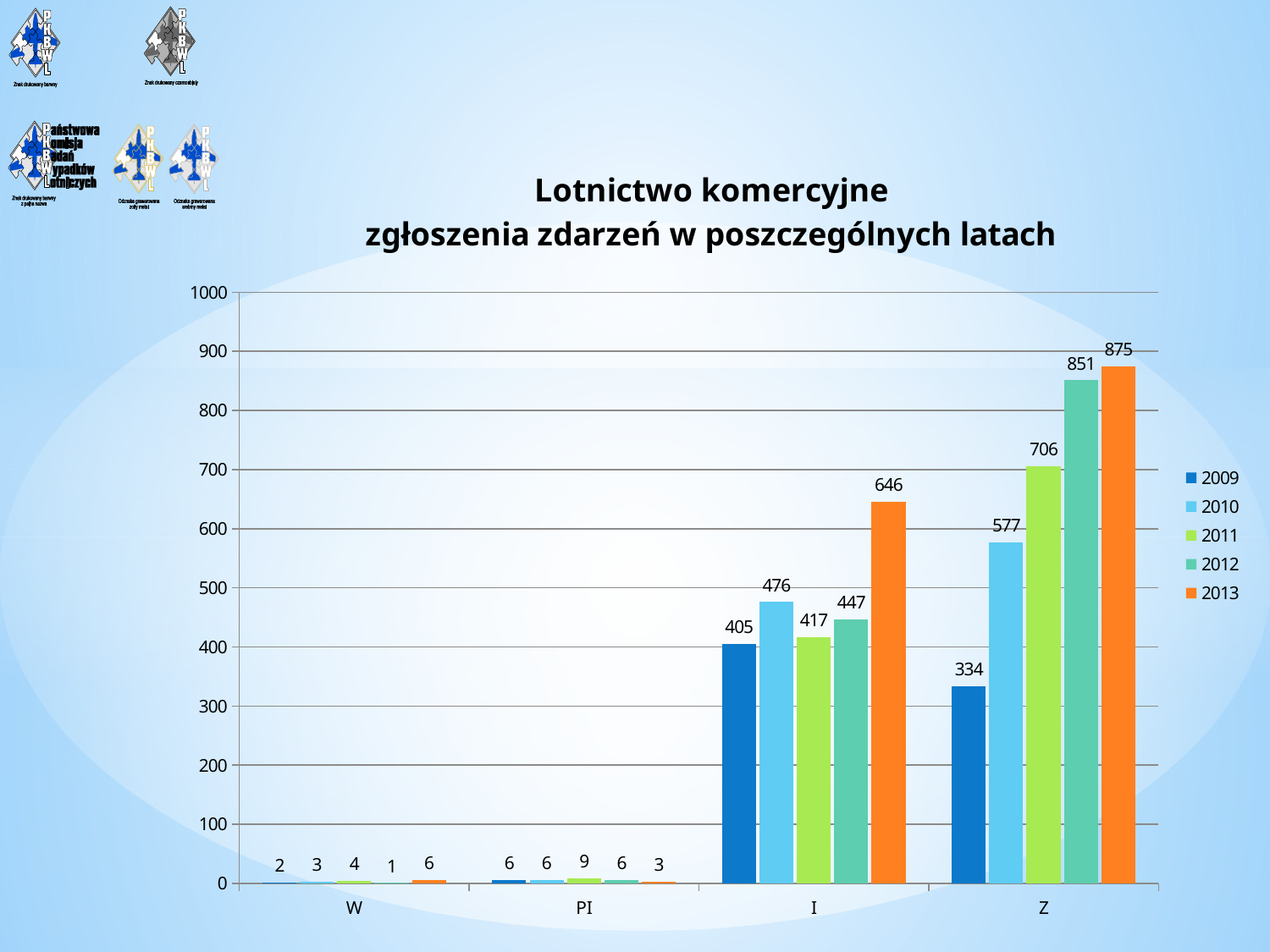
Is the value for category Z in the 2011 series greater or less than 700? greater What kind of chart is shown on the slide? bar chart How many series does the legend list? 5 How many categories are shown on the x axis? 4 What is the value for category Z in the 2013 series? 875 Which category has the highest value in the 2009 series? I What is the value for category I in the 2010 series? 476 Which is larger for category I: the 2011 value or the 2012 value? 2012 What is the value for category PI in the 2011 series? 9 What is the difference between the 2013 and 2009 values for category Z? 541 Which category has the lowest value in the 2013 series? PI What is the value for category W in the 2012 series? 1